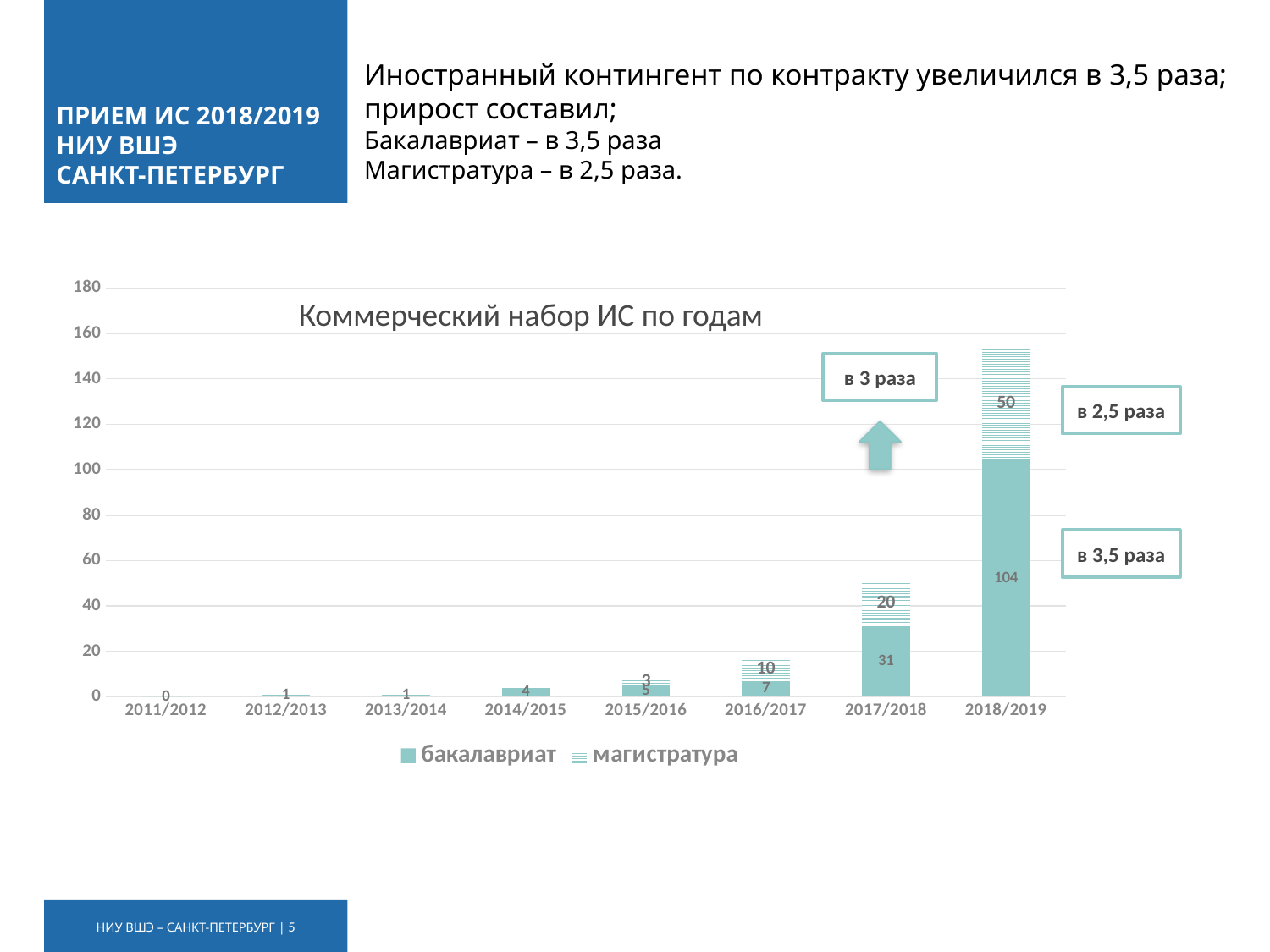
How many academic years are shown on the x axis of the chart? 8 Which year has the highest value for бакалавриат? 2018/2019 What type of chart is shown on the slide? stacked bar chart What is the title of the chart? Коммерческий набор ИС по годам What is the value for магистратура in 2017/2018? 20 Which is larger in 2016/2017: бакалавриат or магистратура? магистратура What is the total of the stacked bar for 2018/2019? 154 How many series does the chart legend list? 2 What is the total of the stacked bar for 2017/2018? 51 What is the value for бакалавриат in 2018/2019? 104 What is the difference between the бакалавриат values for 2018/2019 and 2017/2018? 73 What is the value for бакалавриат in 2016/2017? 7